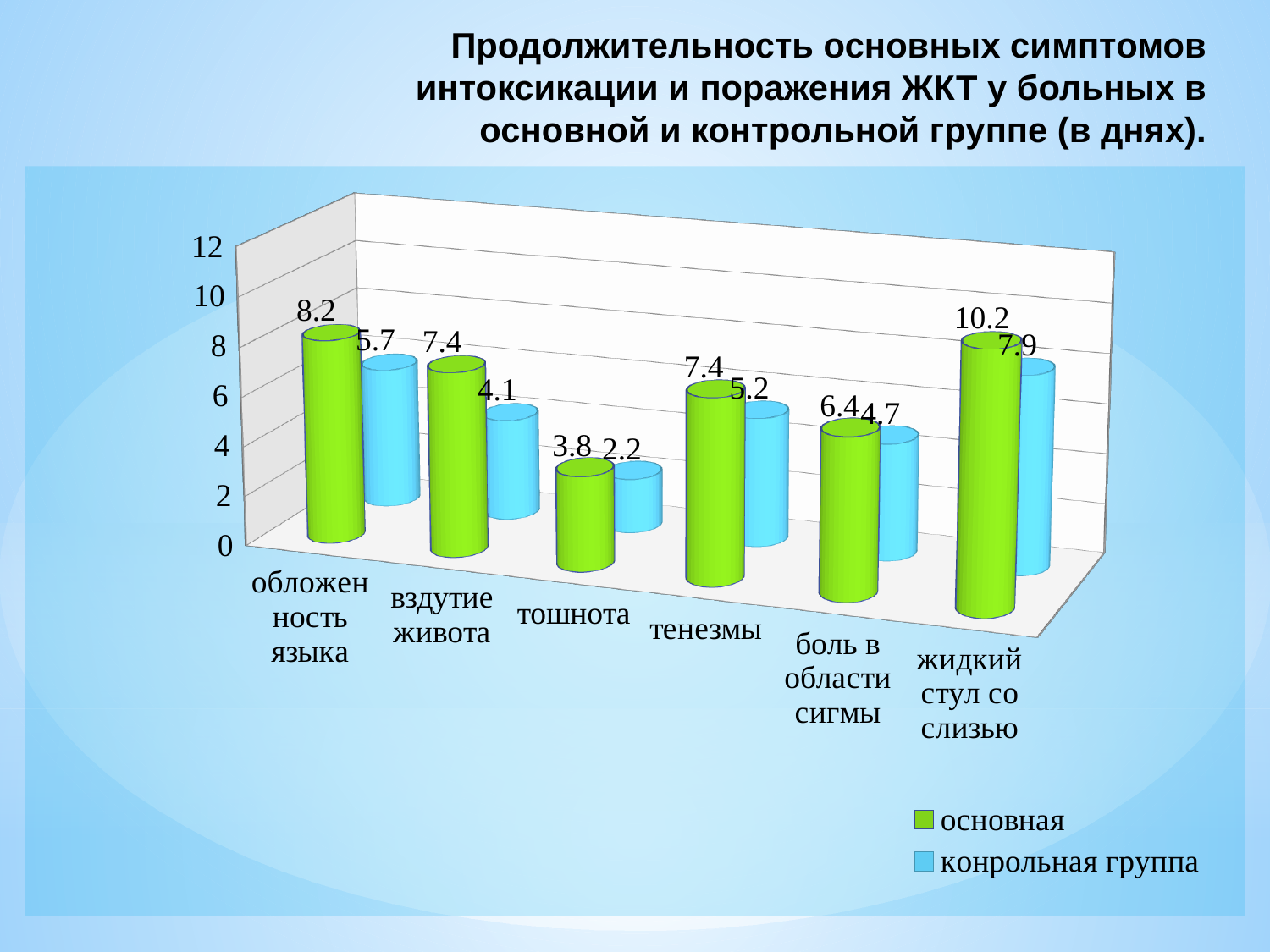
Which category has the highest value for основная? жидкий стул со слизью What is the value for конрольная группа for тенезмы? 5.2 How many categories are shown on the x axis? 6 Which is larger for боль в области сигмы: основная or конрольная группа? основная Which colour represents the основная series? green How many series does the legend list? 2 What is the value for основная for обложенность языка? 8.2 What kind of chart is shown on the slide? bar chart Which category has the lowest value for конрольная группа? тошнота What is the value for конрольная группа for тошнота? 2.2 What is the value for основная for жидкий стул со слизью? 10.2 What is the difference between основная and конрольная группа for вздутие живота? 3.3